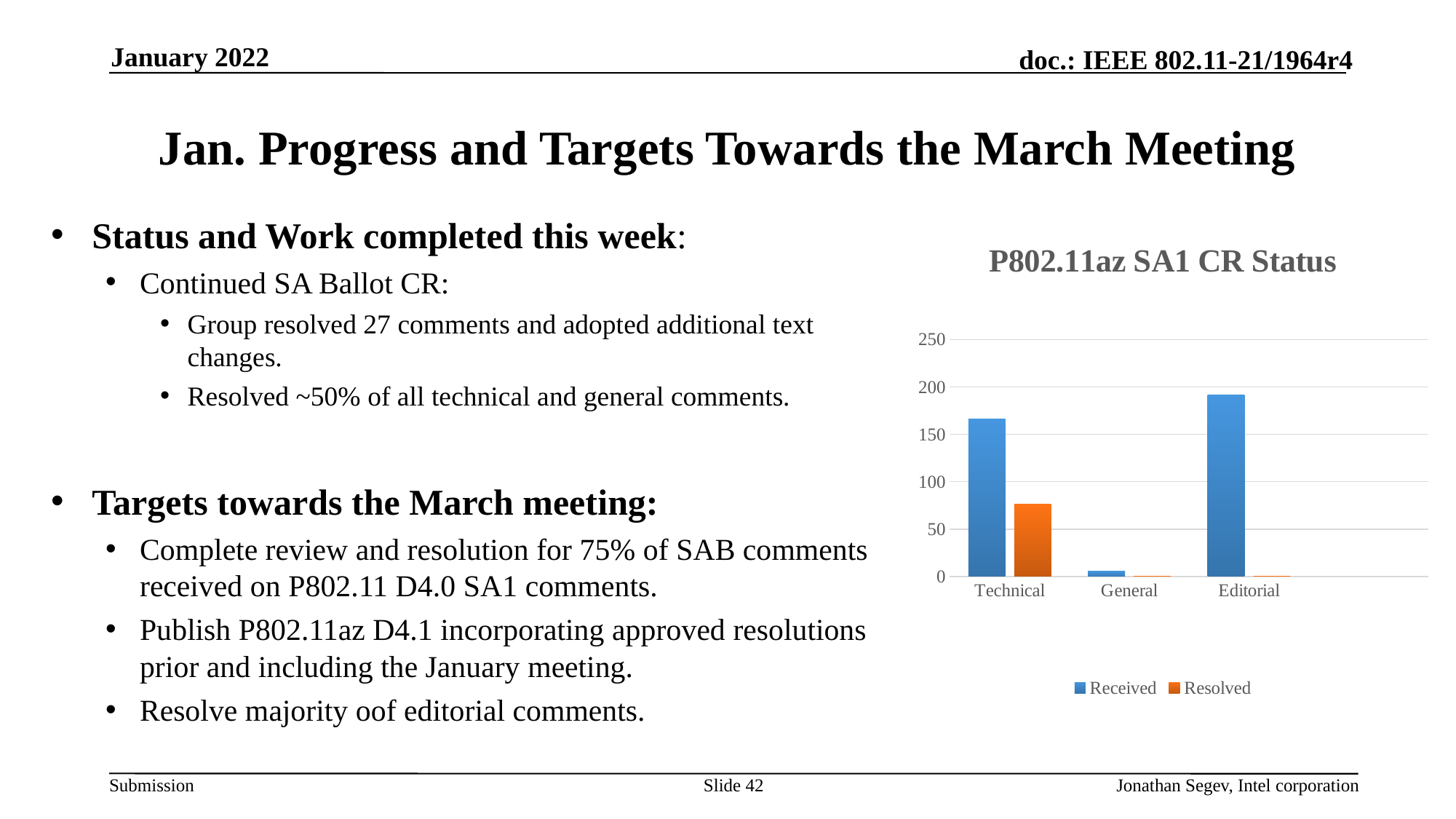
Which category has the highest Resolved value? Technical What kind of chart is shown on the slide? bar chart Which category has the lowest Received value? General Is the Received value for Technical greater or less than 150? greater How many series does the chart's legend list? 2 Which colour represents the Resolved series in the chart? orange How many categories are shown on the x axis of the chart? 3 Which category has the highest Received value? Editorial Is the Resolved value for Technical greater or less than 100? less Which is larger, the Received value for Technical or the Received value for Editorial? Editorial What is the title of the chart on the slide? P802.11az SA1 CR Status